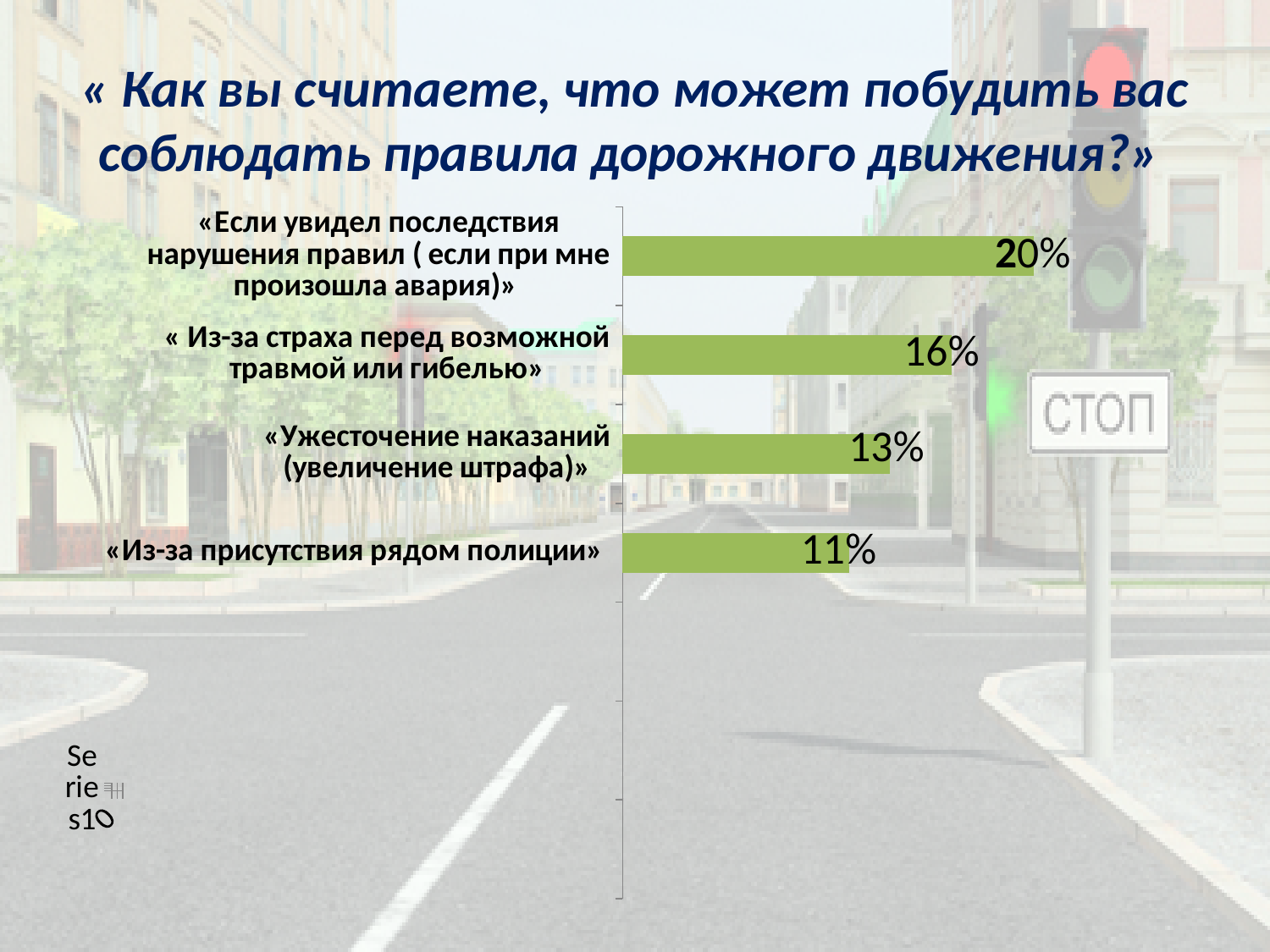
What kind of chart is shown on the slide? Bar chart What colour are the bars in the chart? Green What is the difference between the values for « Из-за страха перед возможной травмой или гибелью» and «Ужесточение наказаний (увеличение штрафа)»? 3% What value is shown for «Из-за присутствия рядом полиции»? 11% Which category has the lowest value? «Из-за присутствия рядом полиции» How many categories are shown in the chart? 4 What value is shown for «Если увидел последствия нарушения правил ( если при мне произошла авария)»? 20% Which is larger: the value for «Ужесточение наказаний (увеличение штрафа)» or the value for «Из-за присутствия рядом полиции»? «Ужесточение наказаний (увеличение штрафа)» What value is shown for «Ужесточение наказаний (увеличение штрафа)»? 13% What value is shown for « Из-за страха перед возможной травмой или гибелью»? 16% What is the difference between the values for «Если увидел последствия нарушения правил ( если при мне произошла авария)» and «Из-за присутствия рядом полиции»? 9% Which category has the highest value? «Если увидел последствия нарушения правил ( если при мне произошла авария)»